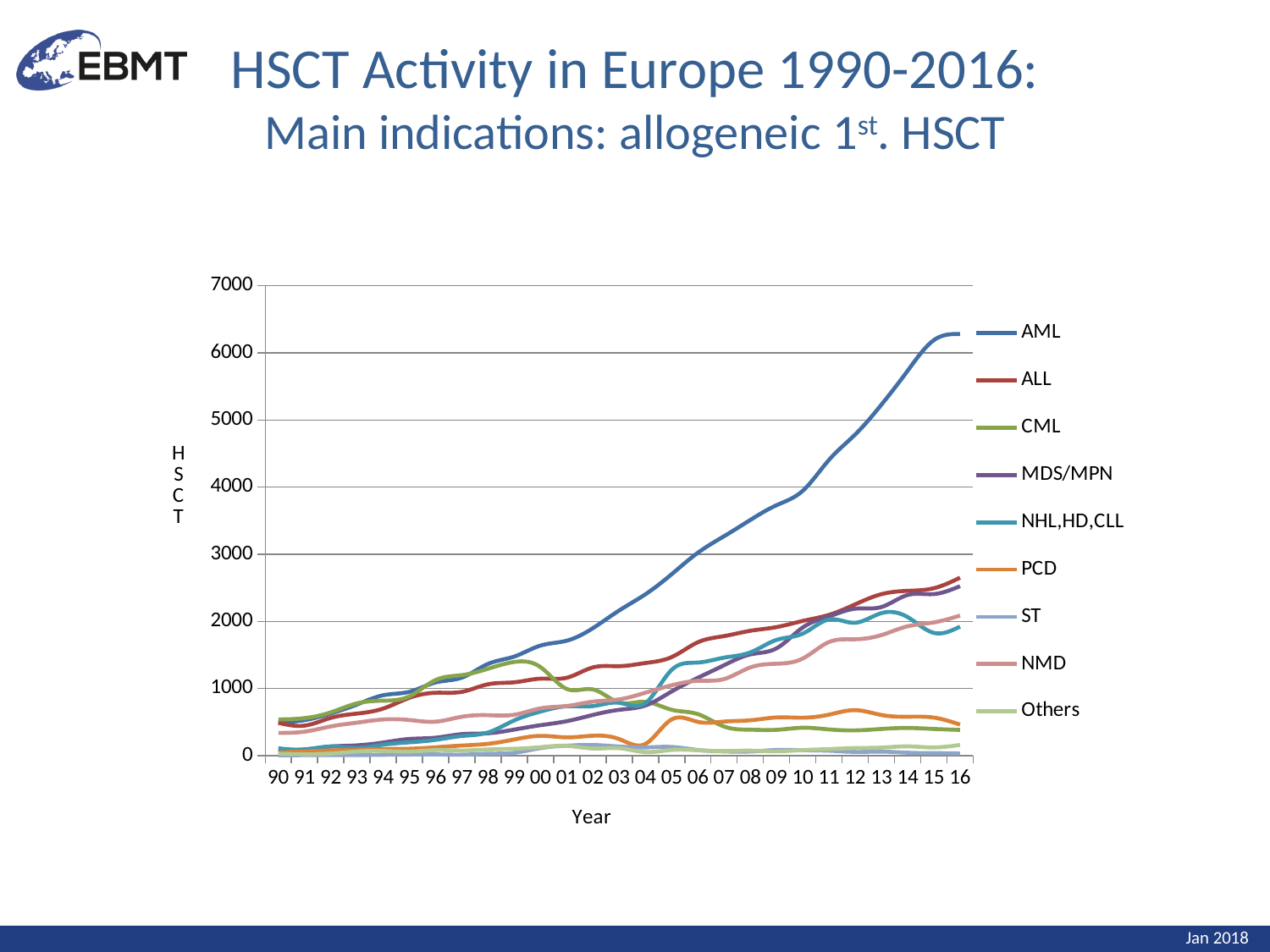
Which series has the highest value in 2016 (16)? AML Is the value for AML in 10 greater or less than 3000? greater How many series does the legend list? 9 What kind of chart is shown on the slide? line chart Is the value for AML in 16 greater or less than 6000? greater Does the CML series rise or fall from 99 to 16? fall Which is larger in 16, the value for ALL or the value for CML? ALL Is the value for PCD in 16 greater or less than 1000? less Does the AML series rise or fall from 90 to 16? rise How many years are plotted along the x axis? 27 What is the title of the x axis? Year